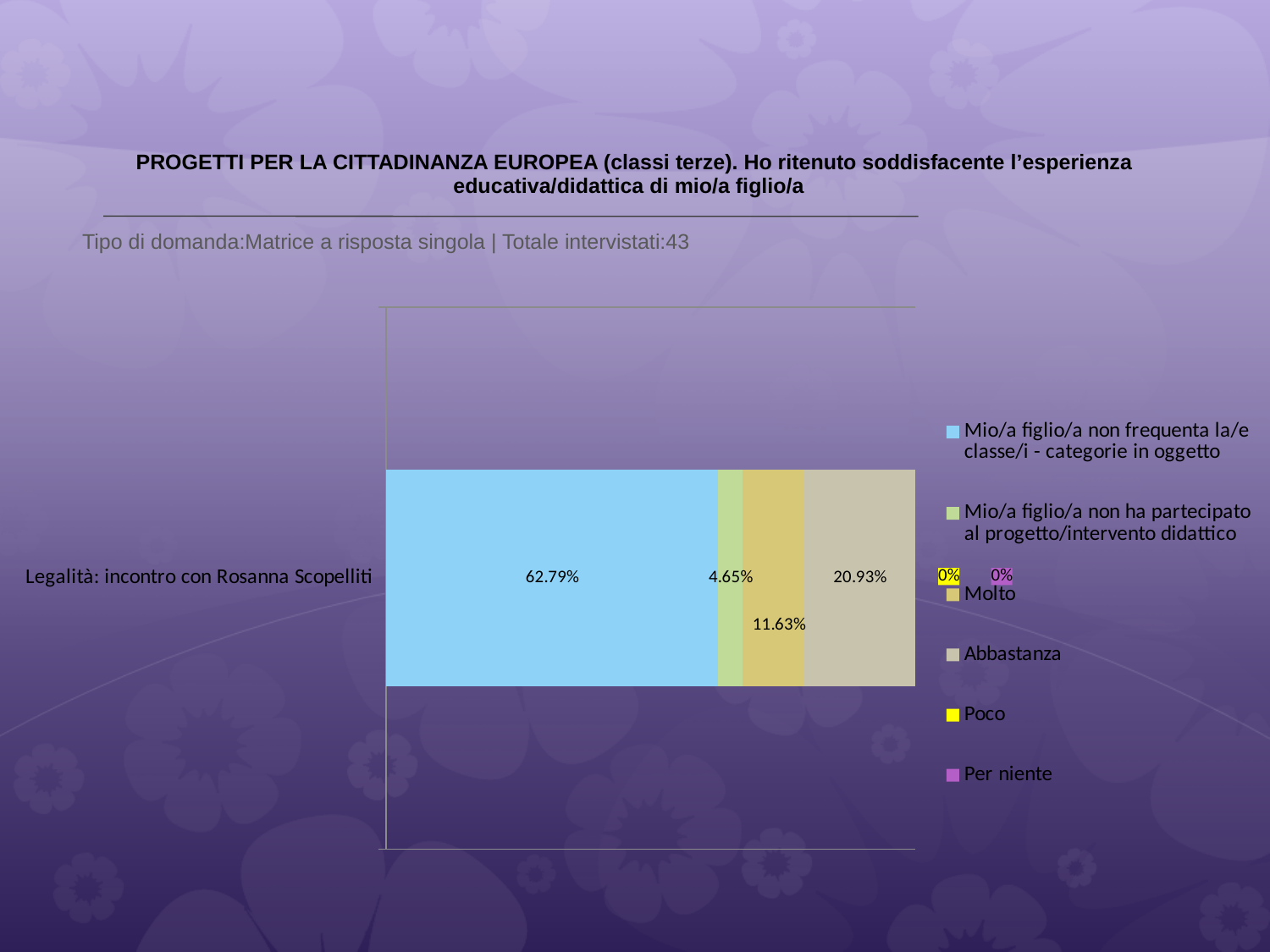
What is the value for 'Mio/a figlio/a non ha partecipato al progetto/intervento didattico'? 4.65% What is the difference between the 'Abbastanza' value and the 'Molto' value? 9.30% What kind of chart is shown on the slide? bar chart What is the value for 'Abbastanza' for 'Legalità: incontro con Rosanna Scopelliti'? 20.93% Which series has the highest value in the bar? Mio/a figlio/a non frequenta la/e classe/i - categorie in oggetto What is the category label shown on the chart's axis? Legalità: incontro con Rosanna Scopelliti What is the value for 'Mio/a figlio/a non frequenta la/e classe/i - categorie in oggetto'? 62.79% What is the value for 'Molto' for 'Legalità: incontro con Rosanna Scopelliti'? 11.63% What is the value for 'Poco'? 0% Which is larger, the value for 'Abbastanza' or the value for 'Molto'? Abbastanza How many categories are plotted on the chart? 1 How many series does the legend list? 6